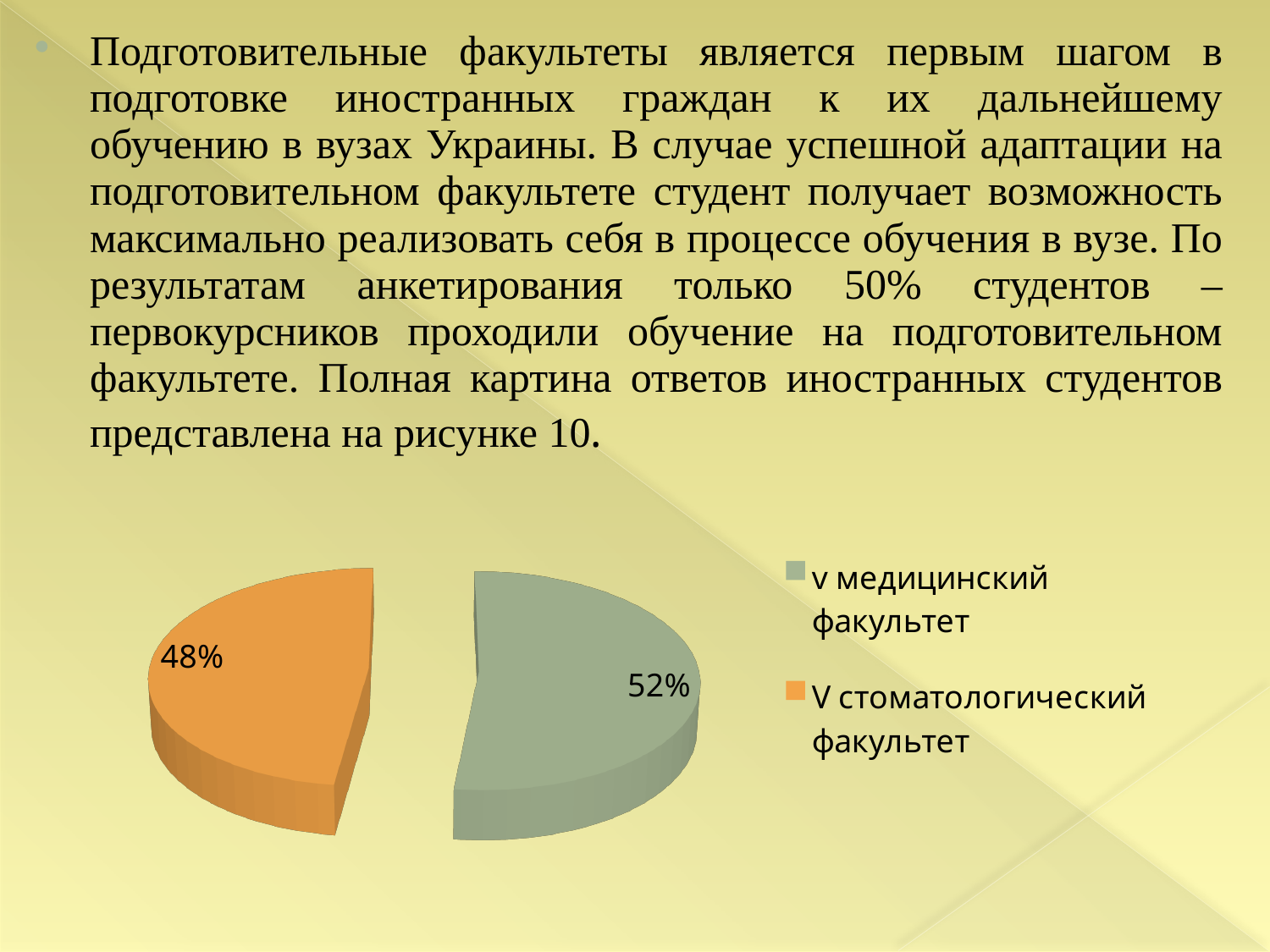
How many slices does the pie chart have? 2 What percentage of the pie is labelled for the стоматологический факультет slice? 48% Which is larger: the share for медицинский факультет or the share for стоматологический факультет? медицинский факультет How many entries does the legend of the pie chart list? 2 What share of the pie does the стоматологический факультет slice represent? 48% What percentage of the pie is labelled for the медицинский факультет slice? 52% What is the difference in percentage points between the медицинский факультет slice and the стоматологический факультет slice? 4% Which slice of the pie chart is the largest? медицинский факультет What kind of chart is shown on the slide? pie chart Which slice of the pie chart is the smallest? стоматологический факультет Is the share for медицинский факультет greater or less than 50%? greater What colour is the slice for стоматологический факультет in the pie chart? orange